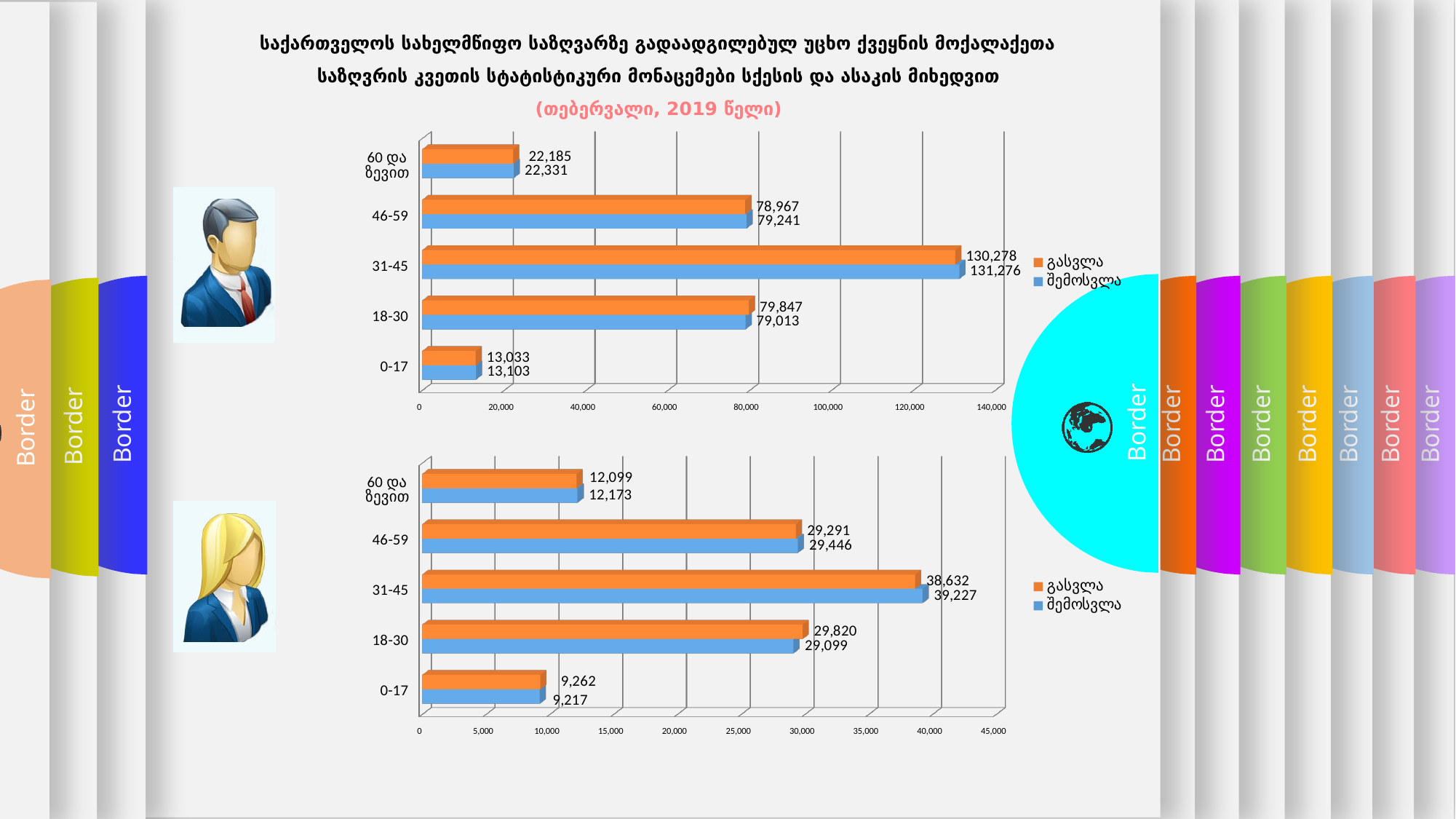
In the bottom chart, which colour represents გასვლა? Orange In the top chart, what is the difference between შემოსვლა and გასვლა for the 31-45 age group? 998 In the bottom chart, what is the value of გასვლა for the 18-30 age group? 29,820 In the bottom chart, what is the difference between გასვლა and შემოსვლა for the 18-30 age group? 721 In the top chart, what is the value of შემოსვლა for the 0-17 age group? 13,103 In the bottom chart, what is the value of შემოსვლა for the 31-45 age group? 39,227 In the top chart, which age group has the highest გასვლა value? 31-45 What type of chart is the top chart? Bar chart How many series does the legend of the bottom chart list? 2 In the top chart, what is the value of გასვლა for the 31-45 age group? 130,278 In the top chart, how many age groups are shown? 5 In the bottom chart, which age group has the lowest შემოსვლა value? 0-17